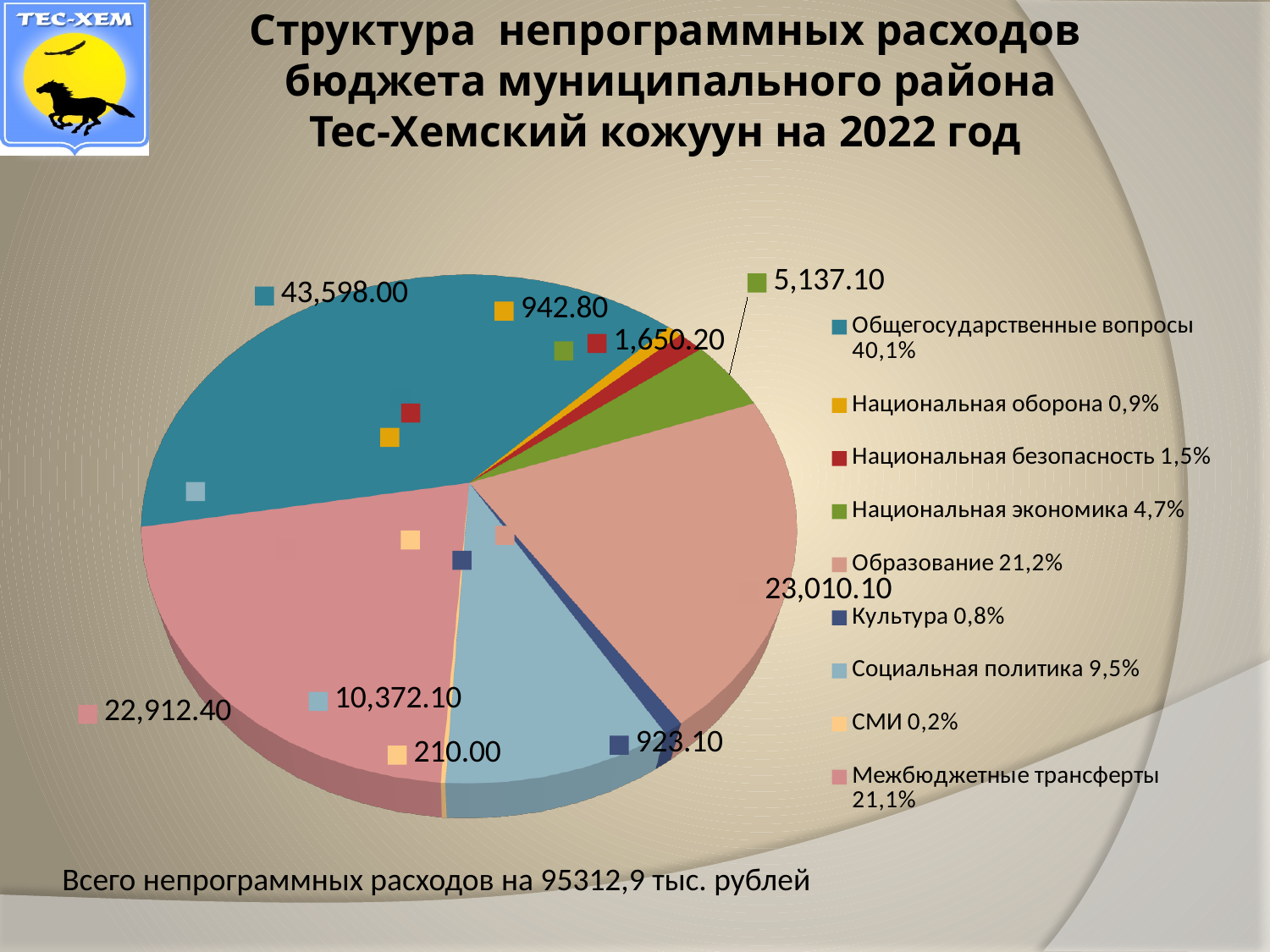
What total amount of non-programme expenditures is stated in the text below the chart? 95312,9 тыс. рублей What is the value shown for Образование? 23,010.10 How many categories does the legend of the pie chart list? 9 What is the difference between the values for Образование and Межбюджетные трансферты? 97.70 What share of the pie does Национальная экономика represent, according to the legend? 4,7% What is the value shown for Социальная политика? 10,372.10 Which category has the smallest slice of the pie? СМИ What type of chart is shown on the slide? Pie chart Which category has the largest slice of the pie? Общегосударственные вопросы Which is larger: the value for Национальная безопасность or the value for Национальная оборона? Национальная безопасность What is the value shown for СМИ? 210.00 What is the value shown for Общегосударственные вопросы? 43,598.00